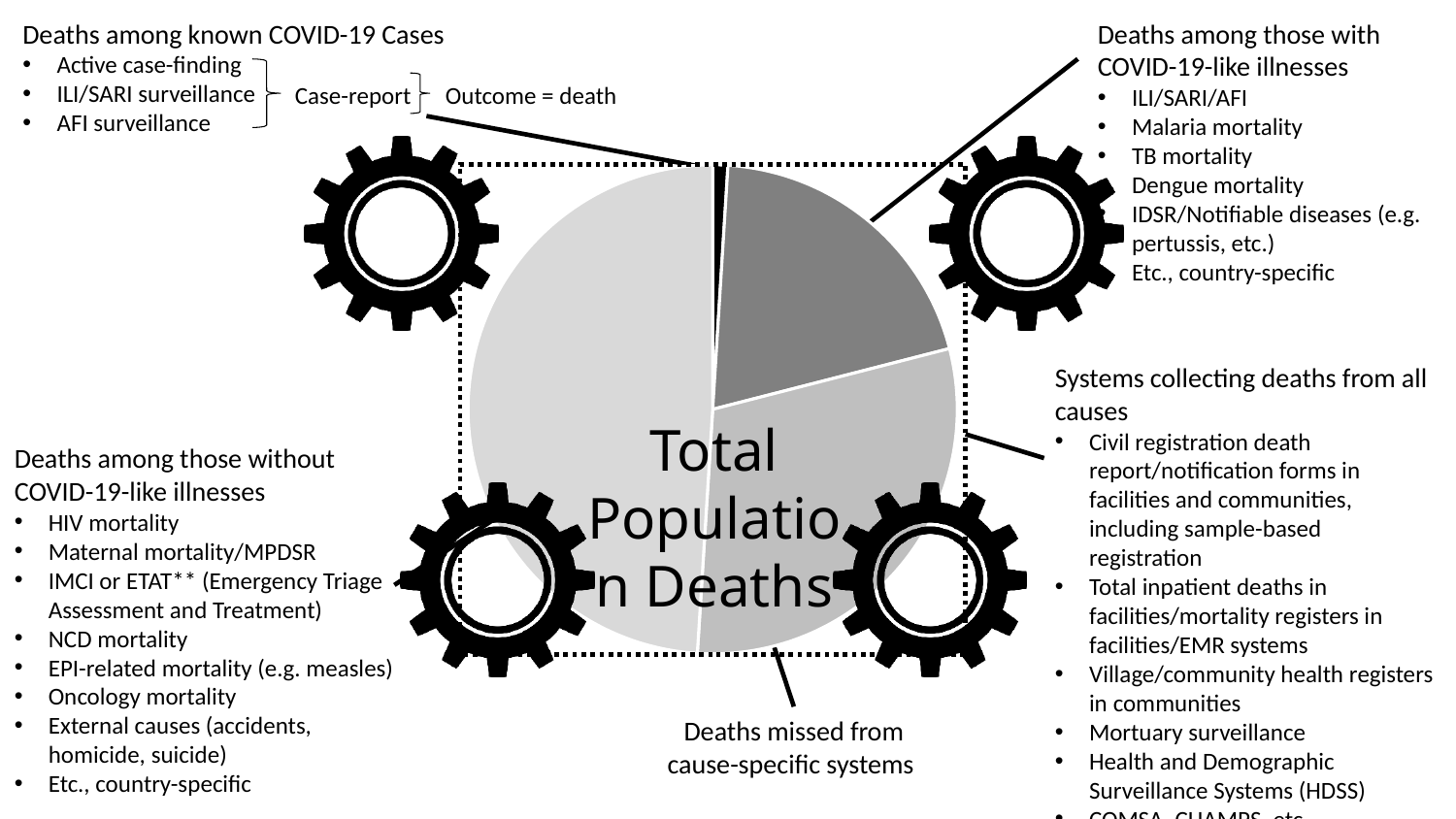
Which slice is larger: Deaths among those without COVID-19-like illnesses or Deaths missed from cause-specific systems? Deaths among those without COVID-19-like illnesses How many slices does the pie chart have? 4 Which slice is larger: Deaths among known COVID-19 Cases or Deaths among those with COVID-19-like illnesses? Deaths among those with COVID-19-like illnesses Does the pie chart print any percentage values on its slices? No Which category has the smallest slice of the pie chart? Deaths among known COVID-19 Cases Which category has the largest slice of the pie chart? Deaths among those without COVID-19-like illnesses What kind of chart is shown on the slide? pie chart What is the title printed in the centre of the pie chart? Total Population Deaths What colour is the slice for Deaths among known COVID-19 Cases? black